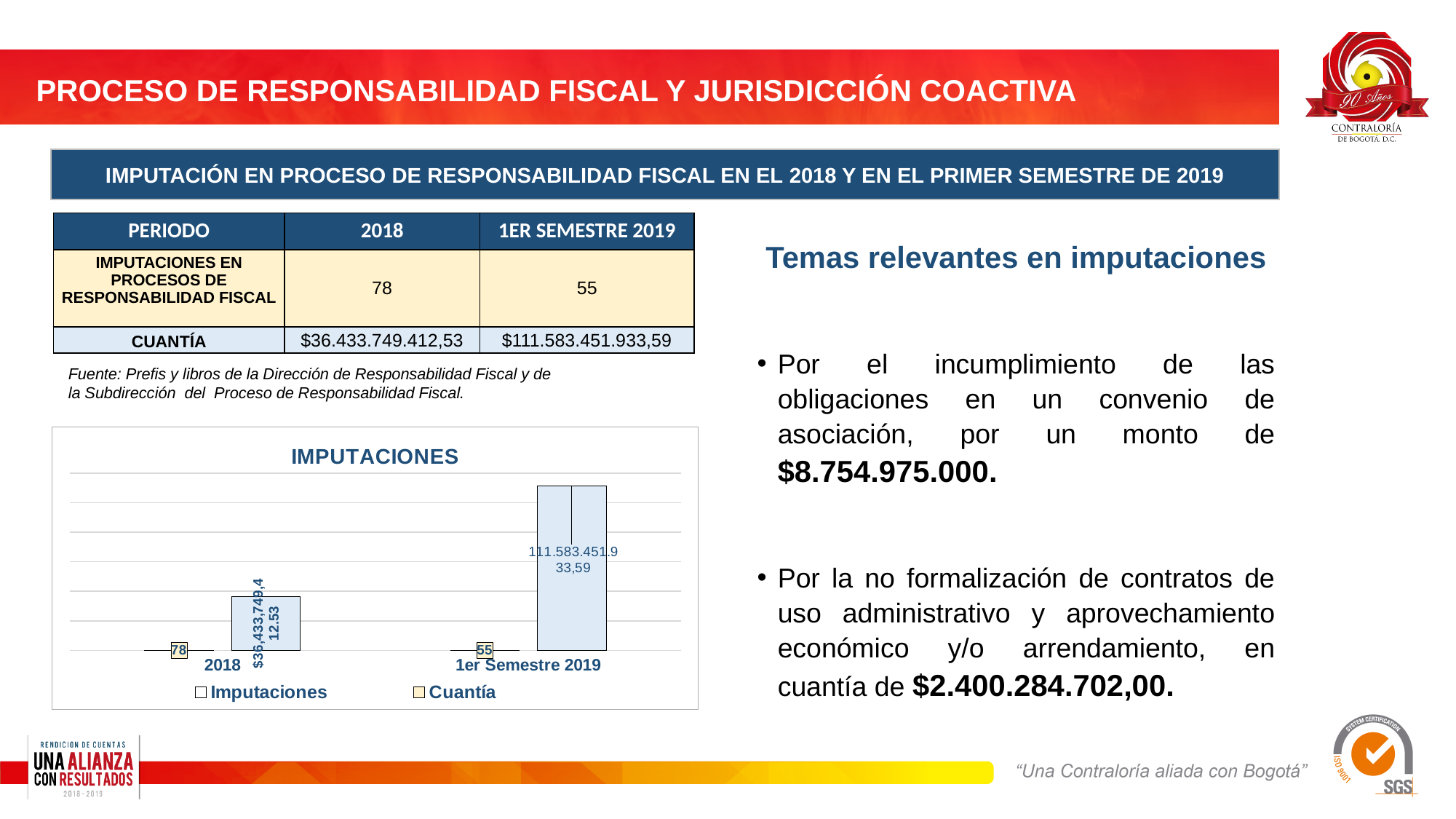
In the IMPUTACIONES chart, what is the Imputaciones value for 1er Semestre 2019? 55 What are the two series named in the legend of the IMPUTACIONES chart? Imputaciones and Cuantía In the IMPUTACIONES chart, which period has the higher Cuantía bar? 1er Semestre 2019 In the IMPUTACIONES chart, what is the Imputaciones value for 2018? 78 In the IMPUTACIONES chart, which period has the higher Imputaciones value? 2018 What type of chart is the IMPUTACIONES chart? bar chart What is the title of the chart on the slide? IMPUTACIONES How many periods (categories) are shown on the x axis of the IMPUTACIONES chart? 2 In the IMPUTACIONES chart, what is the difference between the Imputaciones values for 2018 and 1er Semestre 2019? 23 In the IMPUTACIONES chart, does the Imputaciones value rise or fall from 2018 to 1er Semestre 2019? fall How many series does the legend of the IMPUTACIONES chart list? 2 In the IMPUTACIONES chart, what is the Cuantía value labelled for 1er Semestre 2019? 111.583.451.933,59